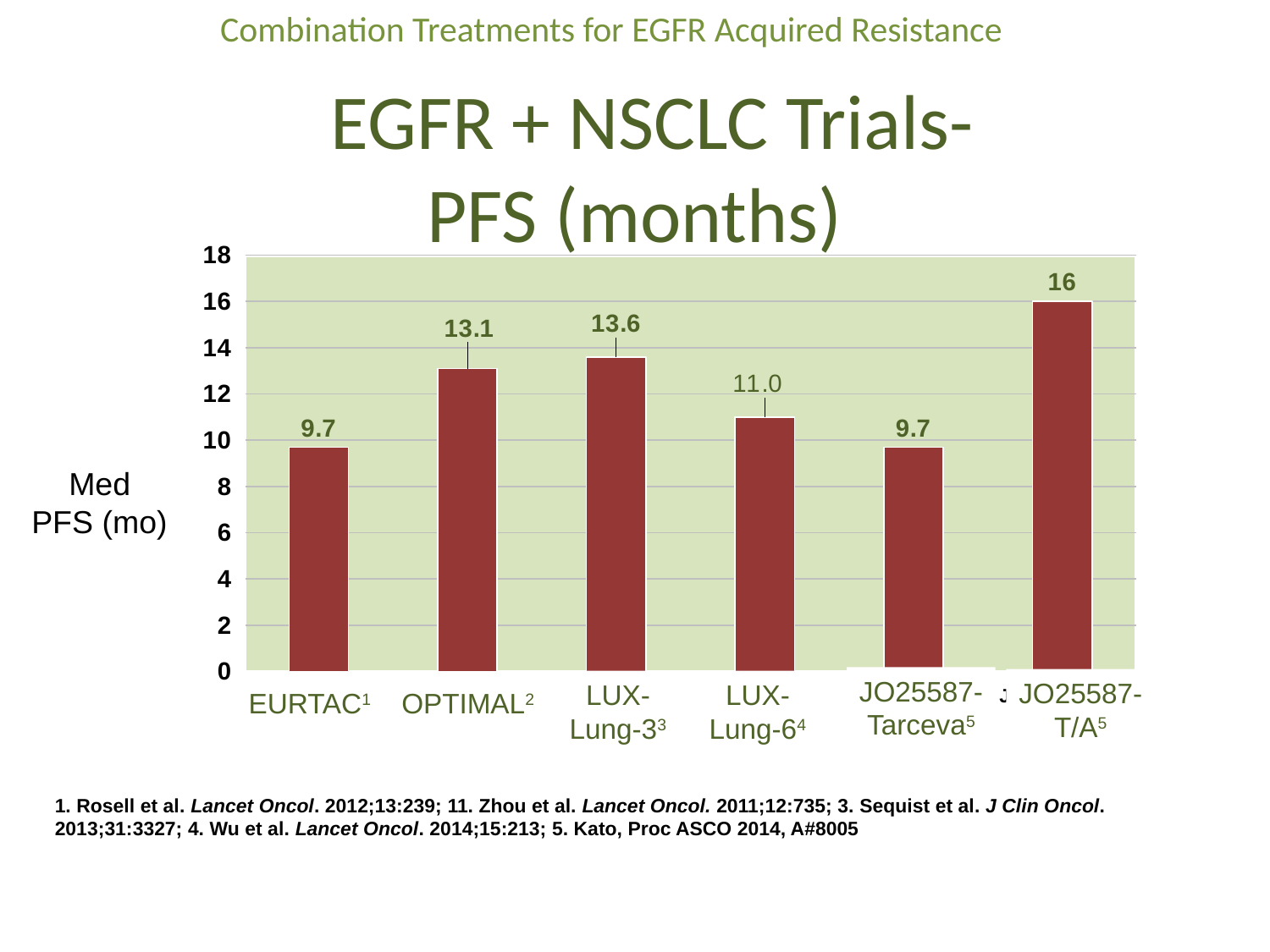
What is the difference in median PFS between JO25587-T/A and JO25587-Tarceva? 6.3 What is the median PFS value shown for LUX-Lung-6? 11.0 What is the difference in median PFS between LUX-Lung-3 and EURTAC? 3.9 What kind of chart is shown on the slide? bar chart How many trials are plotted in the chart? 6 Which two trials share the same median PFS value of 9.7? EURTAC and JO25587-Tarceva Is the median PFS for LUX-Lung-3 greater or less than 12? greater What is the label on the vertical axis of the chart? Med PFS (mo) Which has a larger median PFS, OPTIMAL or LUX-Lung-6? OPTIMAL Which trial has the highest median PFS? JO25587-T/A What is the median PFS value shown for JO25587-T/A? 16 What is the median PFS in months for the OPTIMAL trial? 13.1